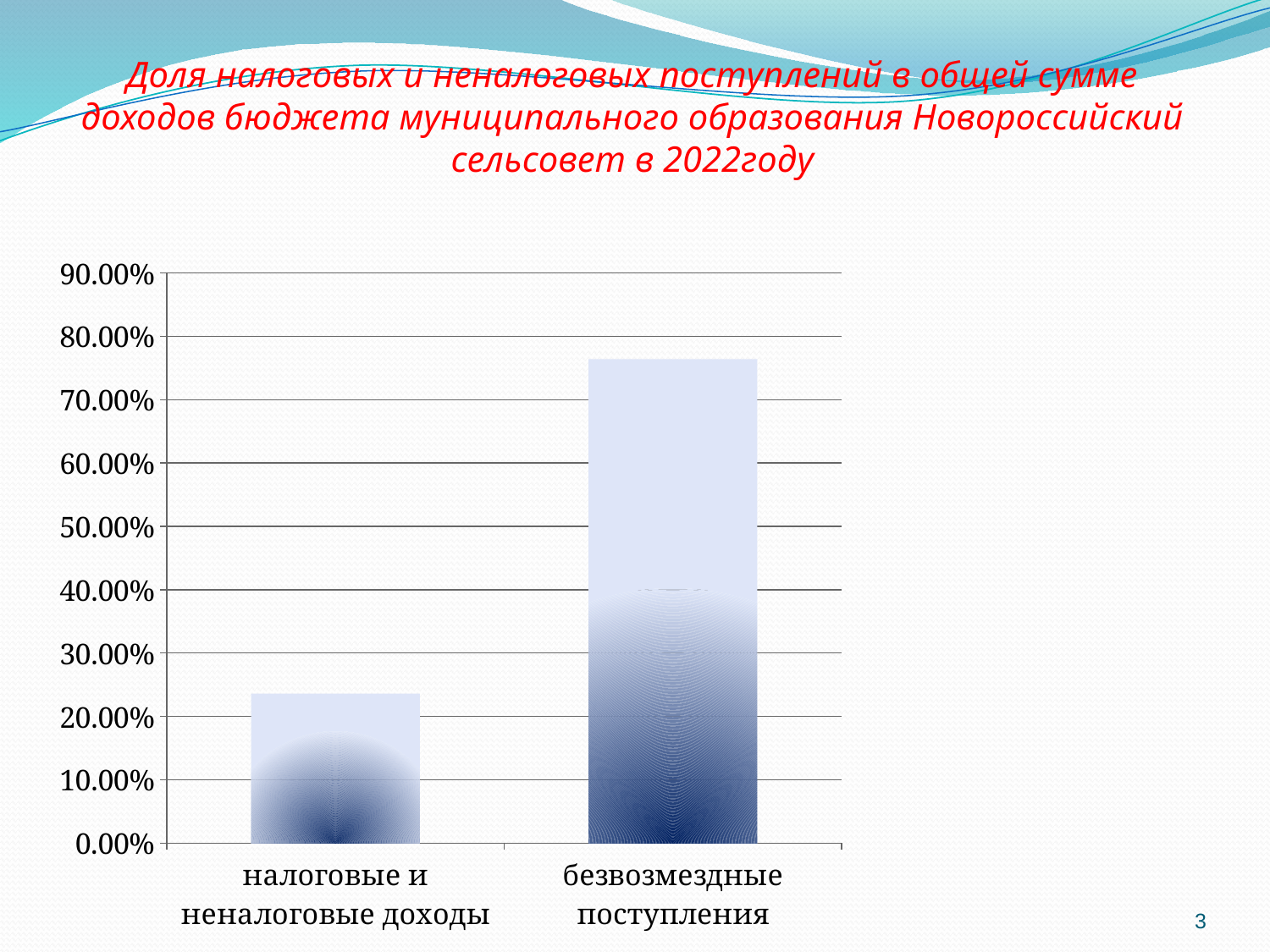
Which is larger: the value for налоговые и неналоговые доходы or the value for безвозмездные поступления? безвозмездные поступления What kind of chart is shown on the slide? bar chart Is the value for налоговые и неналоговые доходы greater or less than 20.00%? greater How many categories are plotted on the chart? 2 Is the value for безвозмездные поступления greater or less than 70.00%? greater Which category has the lowest value? налоговые и неналоговые доходы Which year does the chart title say the data refers to? 2022 Which category has the highest value? безвозмездные поступления Is the value for безвозмездные поступления greater or less than 80.00%? less What is the highest value shown on the vertical axis? 90.00%